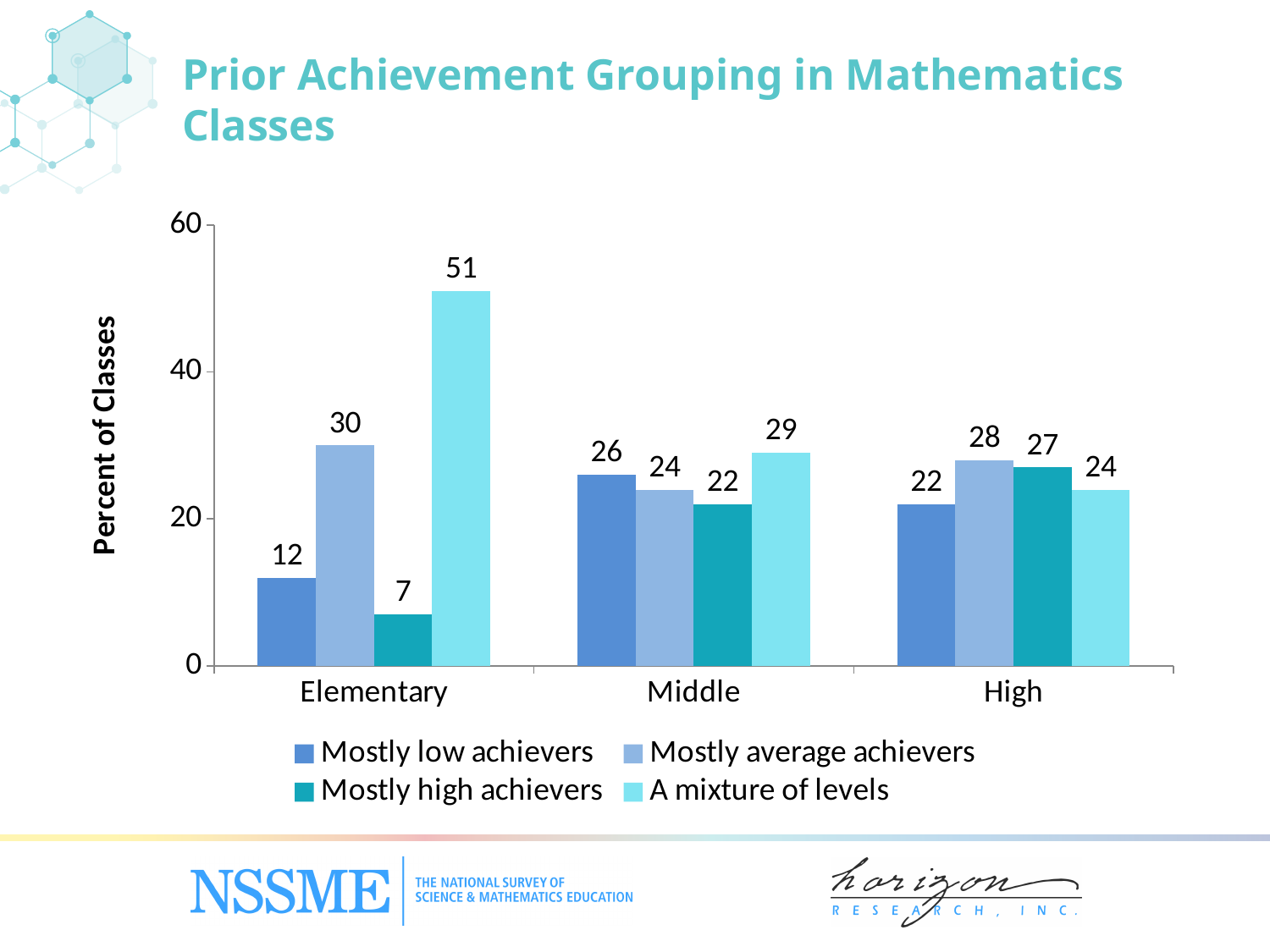
What percent of Elementary classes are grouped as a mixture of levels? 51 Which grade level has the highest value for A mixture of levels? Elementary What is the difference between the A mixture of levels value and the Mostly low achievers value for Elementary classes? 39 What is the value for Mostly low achievers in Middle classes? 26 What is the value for Mostly high achievers in Elementary classes? 7 What is the value for Mostly average achievers in High classes? 28 What kind of chart is shown on the slide? Bar chart Which grade level has the lowest value for Mostly high achievers? Elementary How many series does the legend list? 4 How many grade-level categories are shown on the x axis? 3 Which is larger for Middle classes: Mostly average achievers or A mixture of levels? A mixture of levels What is the label of the y axis? Percent of Classes